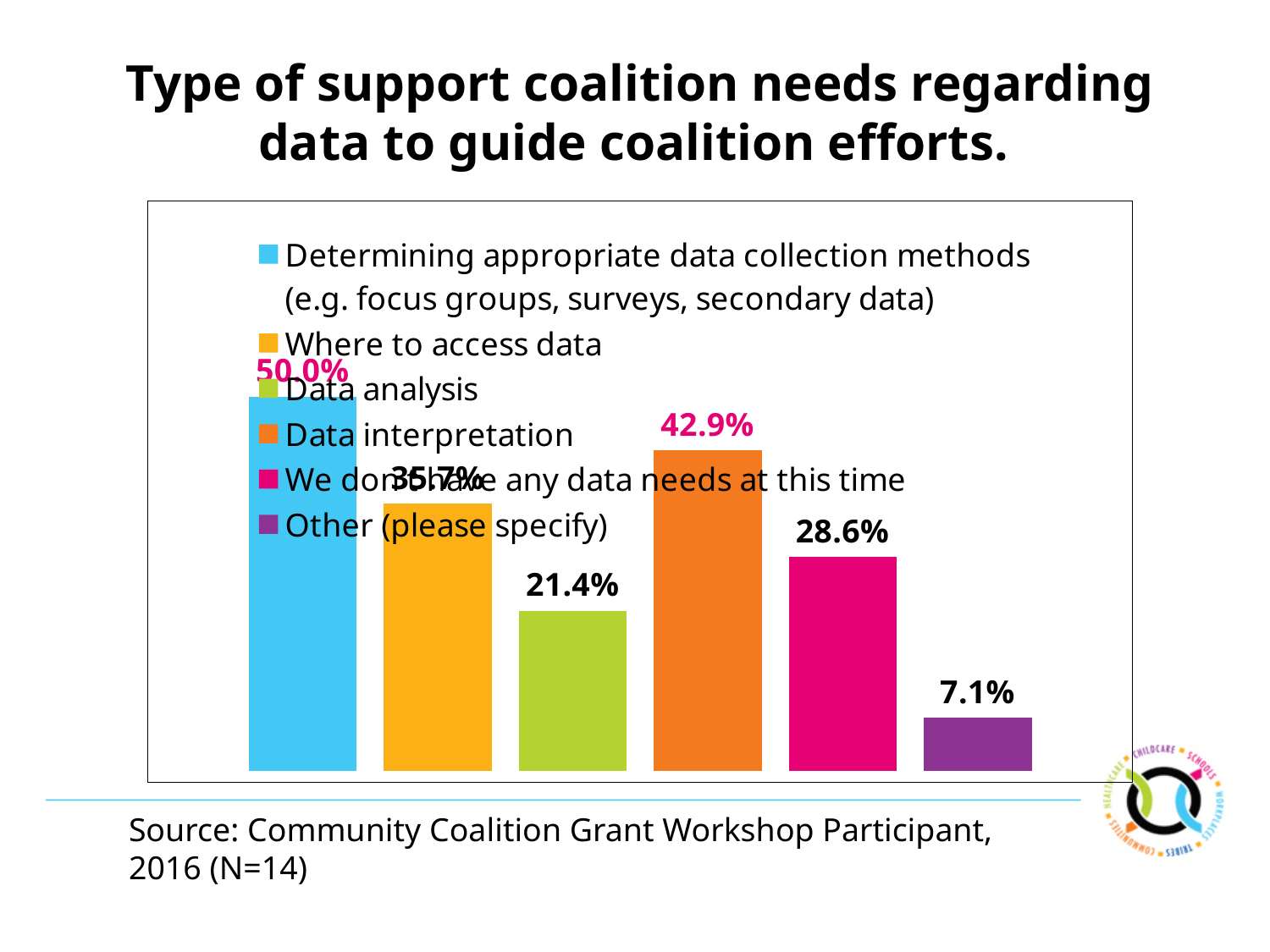
Which type of support has the highest value? Determining appropriate data collection methods (e.g. focus groups, surveys, secondary data) How many entries does the legend list? 6 Which type of support has the lowest value? Other (please specify) What is the value for 'Other (please specify)'? 7.1% What is the value for 'Data interpretation'? 42.9% What kind of chart is shown on the slide? bar chart What colour is the bar for 'Data analysis'? green What is the value for 'Data analysis'? 21.4% What is the value for 'Determining appropriate data collection methods (e.g. focus groups, surveys, secondary data)'? 50.0% Which is larger, the value for 'Data interpretation' or the value for 'We don't have any data needs at this time'? Data interpretation What is the value for 'We don't have any data needs at this time'? 28.6% What is the difference between the values for 'Data interpretation' and 'Data analysis'? 21.5%